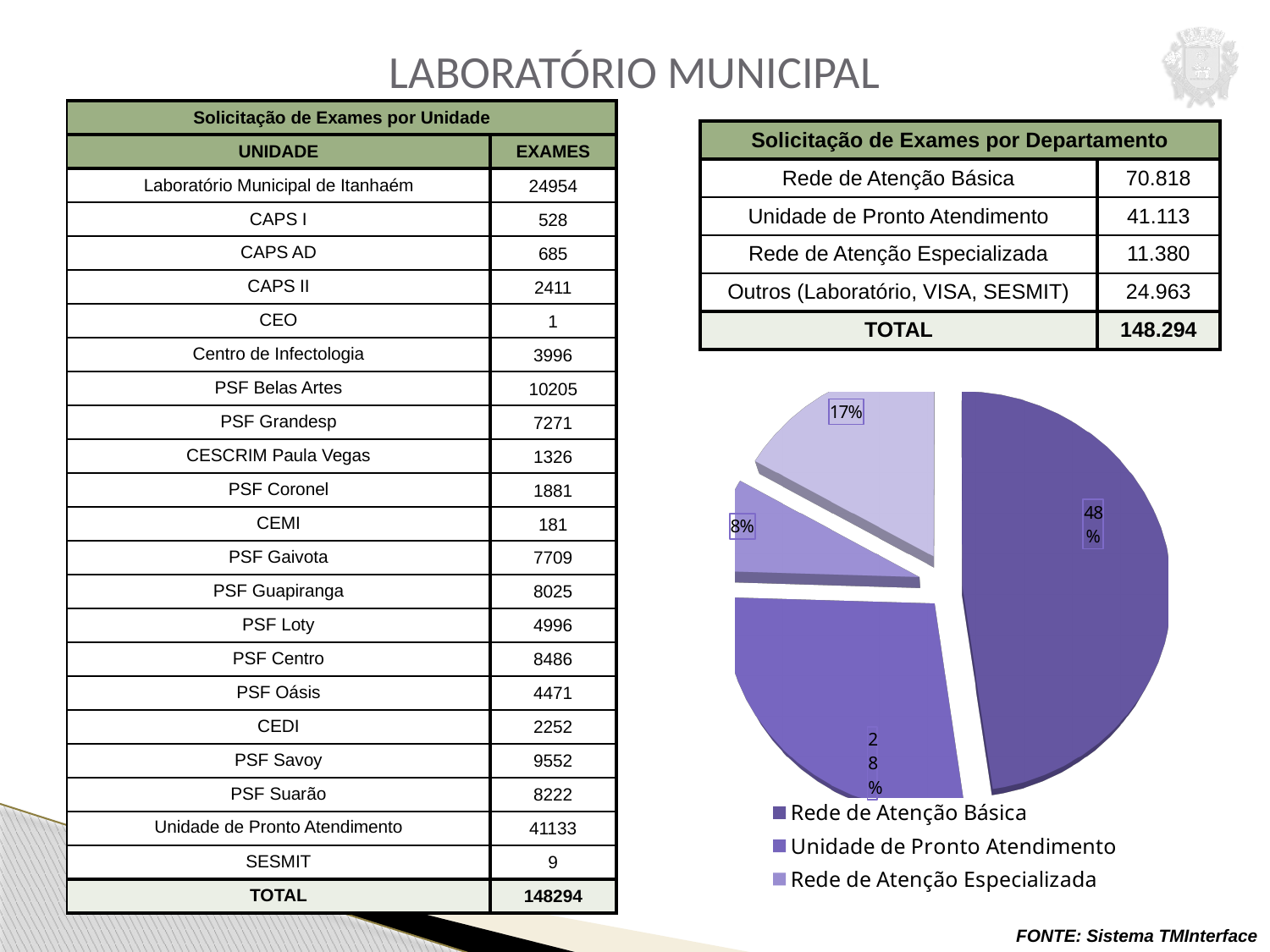
What is the third entry listed in the pie chart's legend? Rede de Atenção Especializada How many slices does the pie chart have? 4 What is the first entry listed in the pie chart's legend? Rede de Atenção Básica How many entries does the pie chart's legend list? 3 In the pie chart, which is larger: Rede de Atenção Básica or Unidade de Pronto Atendimento? Rede de Atenção Básica In the pie chart, what is the difference in percentage points between Rede de Atenção Básica and Unidade de Pronto Atendimento? 20 What share of the pie chart does Rede de Atenção Básica represent? 48% What is the percentage shown on the smallest slice of the pie chart? 8% What share of the pie chart does Unidade de Pronto Atendimento represent? 28% Is the share for Rede de Atenção Básica in the pie chart greater or less than 50%? less Which category has the largest slice in the pie chart? Rede de Atenção Básica What kind of chart is shown on the slide? Pie chart